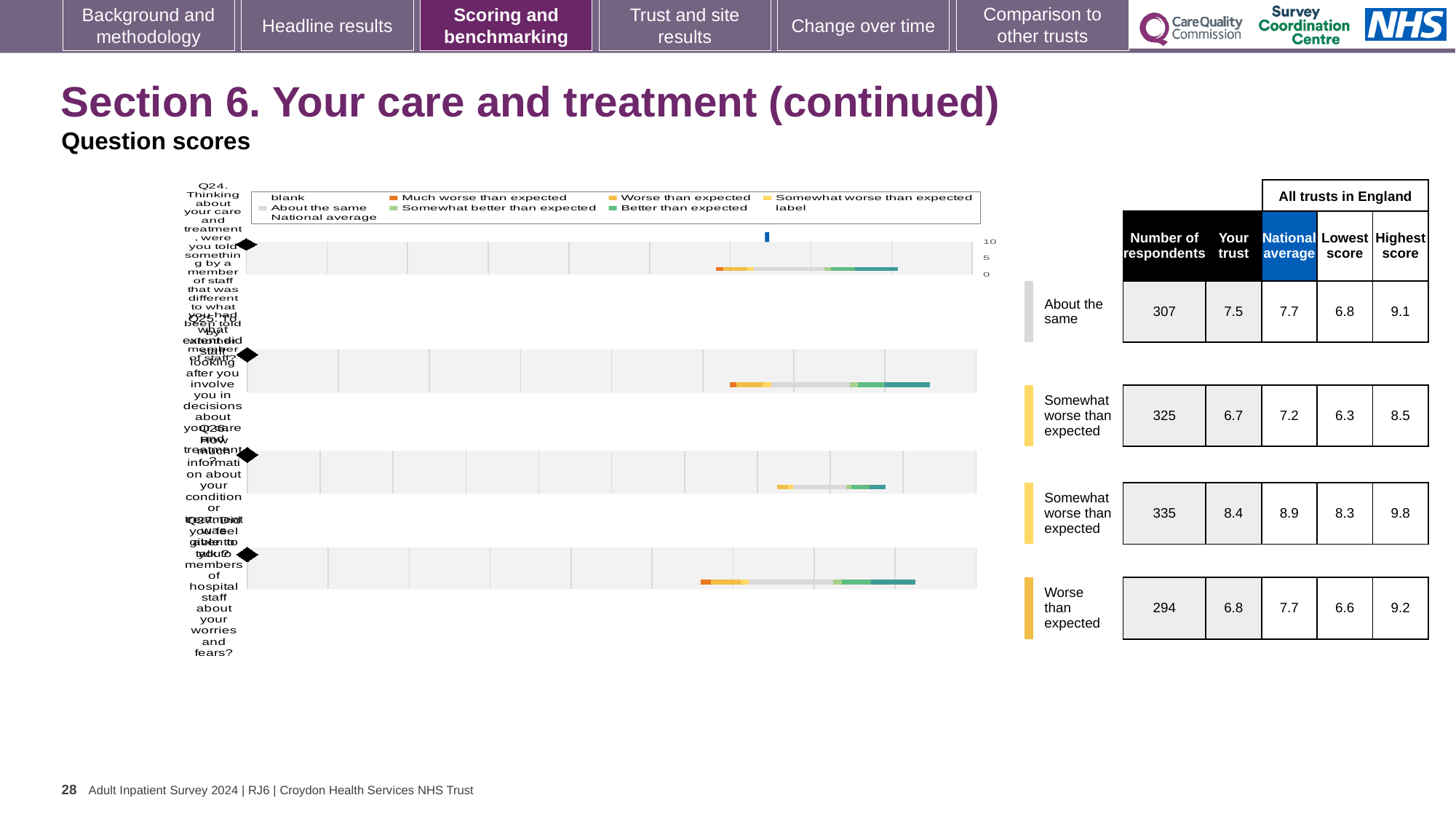
Which row has the highest 'Your trust' score? The third row from the top (335 respondents), with 8.4 Which row has the lowest 'Your trust' score? The second row from the top (325 respondents), with 6.7 What is the lowest score across all trusts in England for the second row from the top (the row with 325 respondents)? 6.3 For the bottom row rated 'Worse than expected', what is the difference between the national average and the 'Your trust' score? 0.9 What kind of chart is shown on the slide? Bar chart How many question rows are plotted in the chart? 4 What is the national average score for the bottom row of the chart, rated 'Worse than expected'? 7.7 What is the highest score across all trusts in England for the third row from the top (the row with 335 respondents)? 9.8 In the table beside the chart, how many respondents are listed for the top row, rated 'About the same'? 307 What is the 'Your trust' score for the top row of the chart, rated 'About the same'? 7.5 How many respondents are listed for the bottom row, rated 'Worse than expected'? 294 For the top row rated 'About the same', which is larger: the 'Your trust' score or the national average? National average